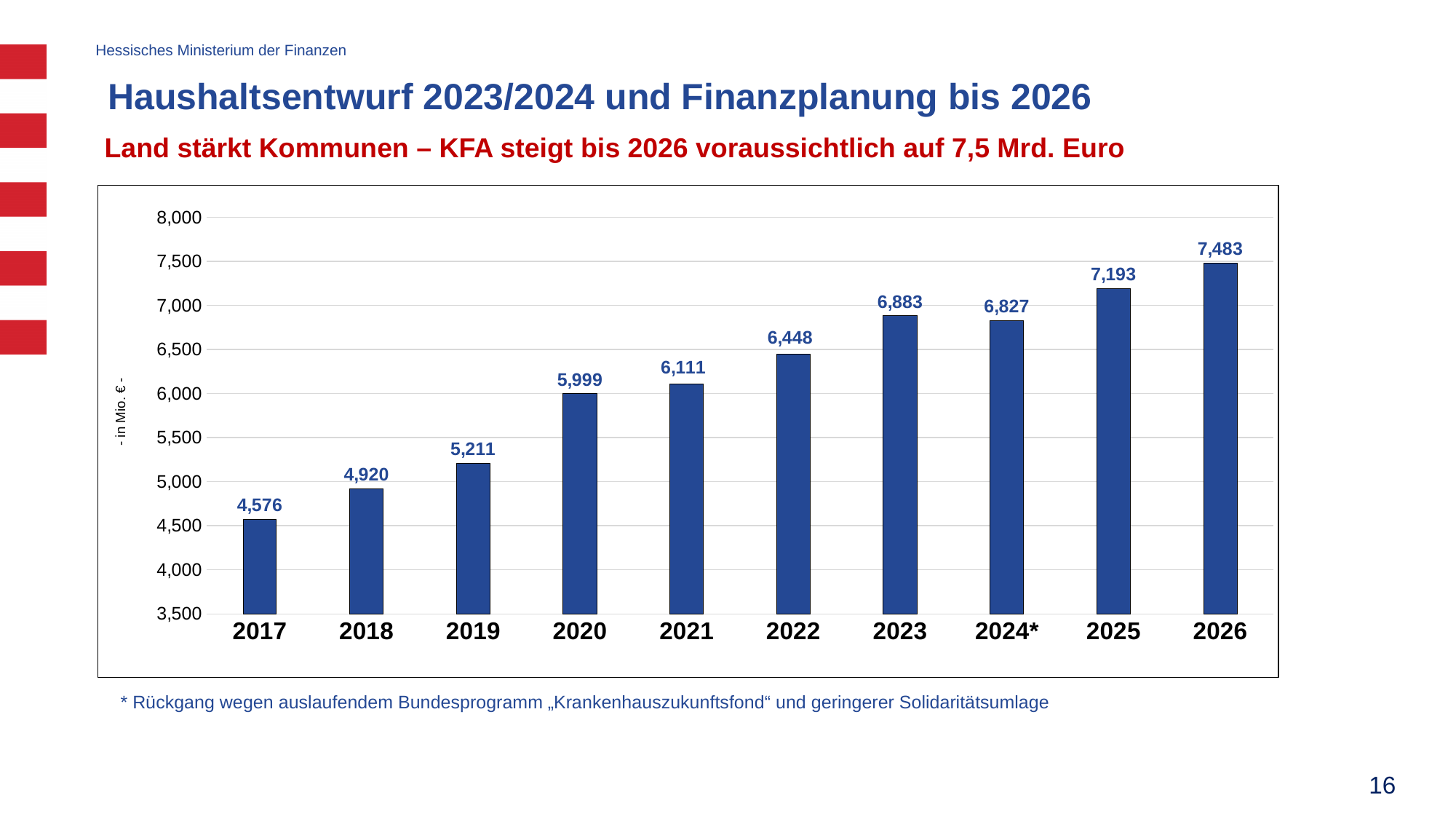
What is the value for 2017? 4,576 What kind of chart is shown on the slide? bar chart Which year has the lowest value? 2017 How many years are shown on the x axis? 10 What is the difference between the values for 2023 and 2024*? 56 What is the difference between the values for 2026 and 2017? 2,907 What is the value for 2024*? 6,827 Which is larger, the value for 2023 or the value for 2024*? 2023 Which year has the highest value? 2026 What is the value for 2026? 7,483 Is the value for 2020 greater or less than 6,000? less What unit is given on the y axis label? in Mio. €